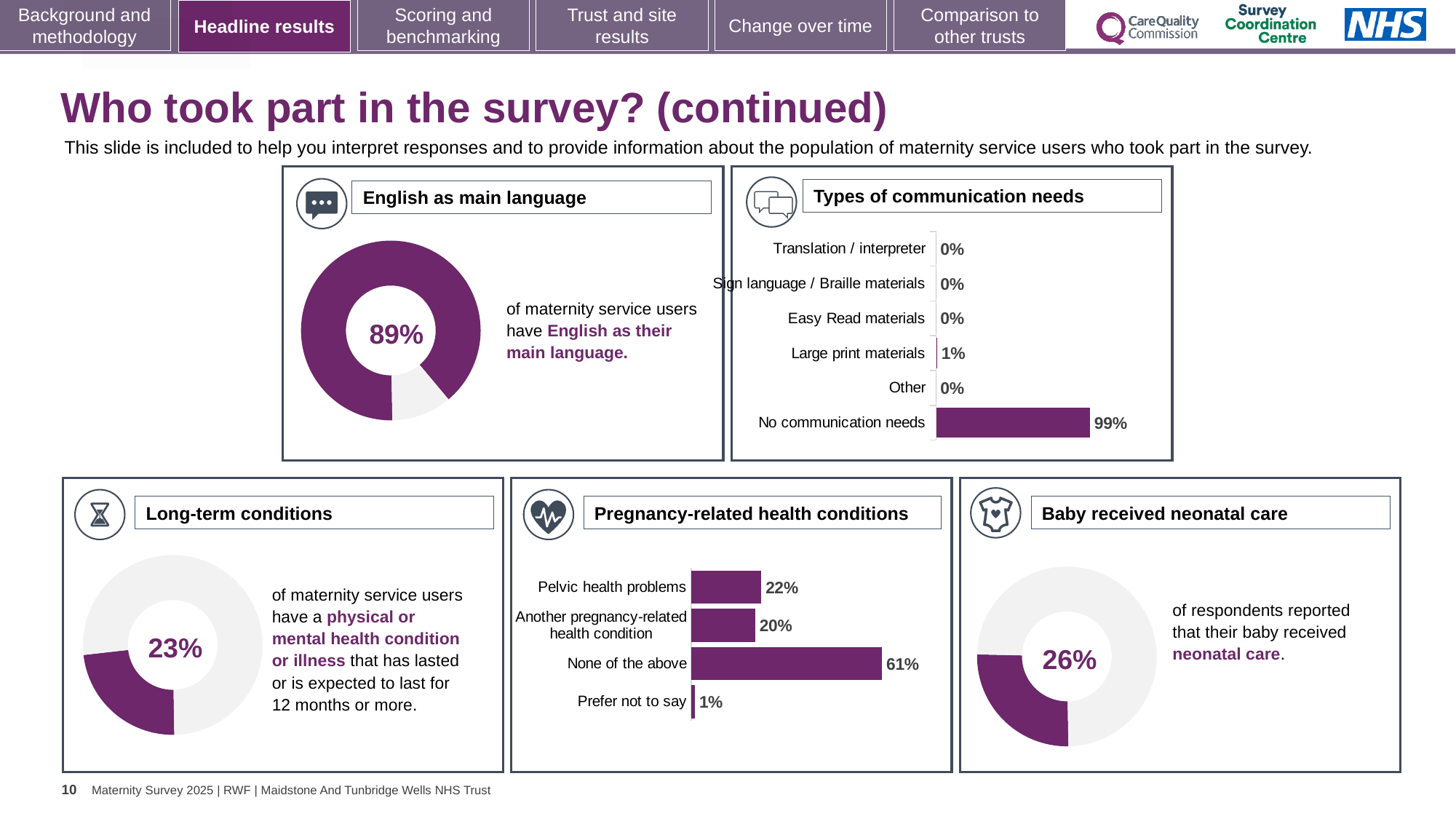
What percentage is shown in the 'Baby received neonatal care' donut chart? 26% In the 'Types of communication needs' chart, what is the value for 'Large print materials'? 1% What kind of chart is the 'Types of communication needs' chart? Bar chart What percentage is shown in the 'English as main language' donut chart? 89% In the 'Pregnancy-related health conditions' chart, what is the value for 'Pelvic health problems'? 22% In the 'Pregnancy-related health conditions' chart, what is the value for 'None of the above'? 61% In the 'Pregnancy-related health conditions' chart, which category has the lowest value? Prefer not to say In the 'Types of communication needs' chart, which category has the highest value? No communication needs In the 'Pregnancy-related health conditions' chart, which is larger: 'Pelvic health problems' or 'Another pregnancy-related health condition'? Pelvic health problems How many categories are shown in the 'Types of communication needs' chart? 6 In the 'Types of communication needs' chart, what is the value for 'No communication needs'? 99% In the 'Pregnancy-related health conditions' chart, what is the difference between 'Pelvic health problems' and 'Another pregnancy-related health condition'? 2%